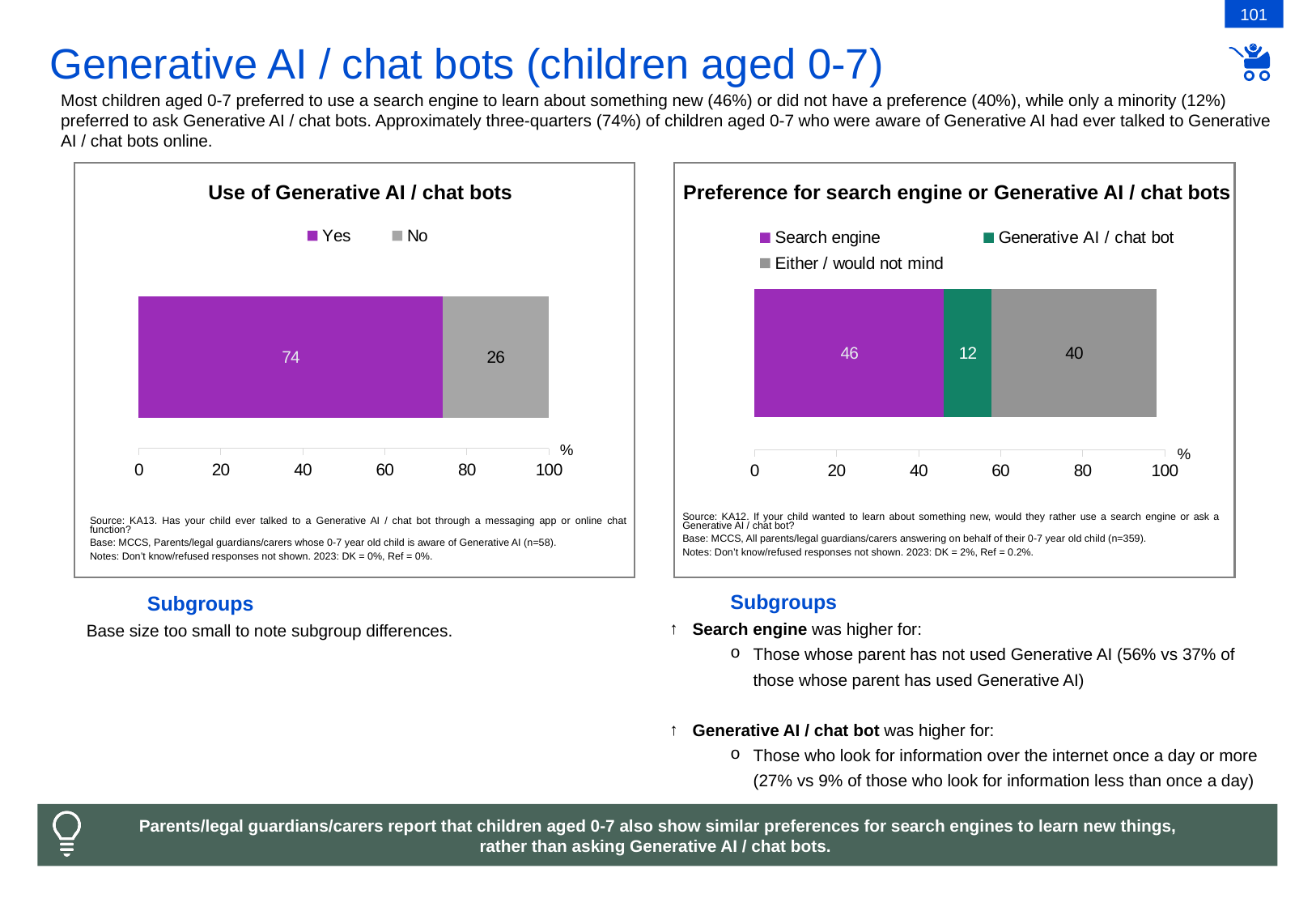
In the 'Use of Generative AI / chat bots' chart, how many series does the legend list? 2 In the 'Preference for search engine or Generative AI / chat bots' chart, how many series does the legend list? 3 What kind of chart is the 'Use of Generative AI / chat bots' chart? Stacked bar chart In the 'Use of Generative AI / chat bots' chart, what is the value for Yes? 74 In the 'Preference for search engine or Generative AI / chat bots' chart, which series has the highest value? Search engine In the 'Preference for search engine or Generative AI / chat bots' chart, what is the difference between the Search engine and Either / would not mind values? 6 In the 'Use of Generative AI / chat bots' chart, what is the difference between the Yes and No values? 48 In the 'Use of Generative AI / chat bots' chart, what is the value for No? 26 In the 'Preference for search engine or Generative AI / chat bots' chart, what is the value for Generative AI / chat bot? 12 In the 'Preference for search engine or Generative AI / chat bots' chart, which series has the lowest value? Generative AI / chat bot In the 'Preference for search engine or Generative AI / chat bots' chart, what is the value for Search engine? 46 In the 'Preference for search engine or Generative AI / chat bots' chart, what is the value for Either / would not mind? 40